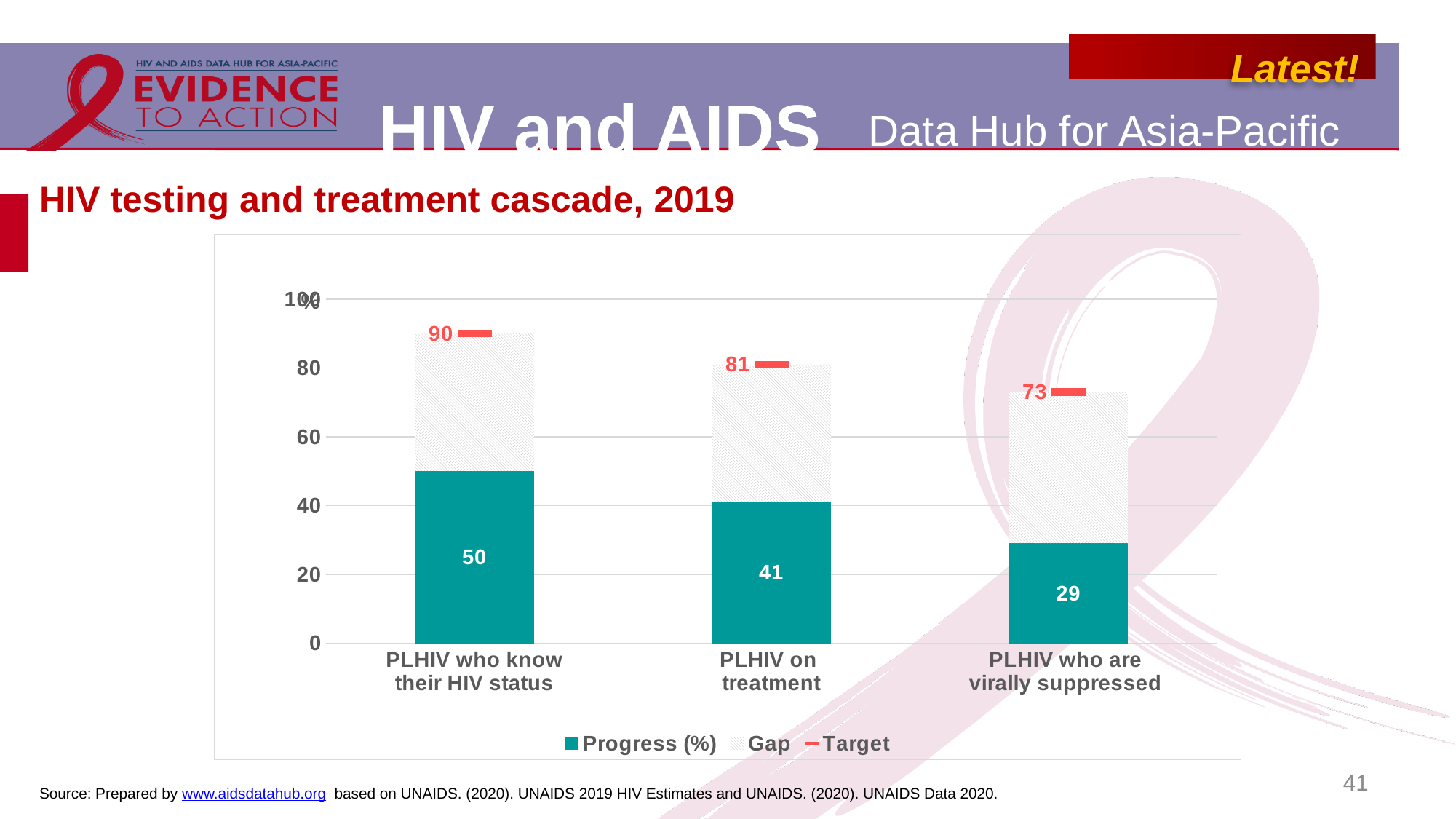
How many series does the legend list? 3 Is the Progress (%) value for PLHIV on treatment larger or smaller than the Progress (%) value for PLHIV who are virally suppressed? larger What is the Progress (%) value for PLHIV who are virally suppressed? 29 What is the difference between the Target and the Progress (%) value for PLHIV who know their HIV status? 40 What is the Progress (%) value for PLHIV on treatment? 41 What is the Target value for PLHIV on treatment? 81 What is the Progress (%) value for PLHIV who know their HIV status? 50 Do the Progress (%) values rise or fall from left to right along the x axis? fall How many categories are shown on the x axis? 3 Which category has the highest Progress (%) value? PLHIV who know their HIV status Which category has the lowest Target value? PLHIV who are virally suppressed What is the Target value for PLHIV who are virally suppressed? 73